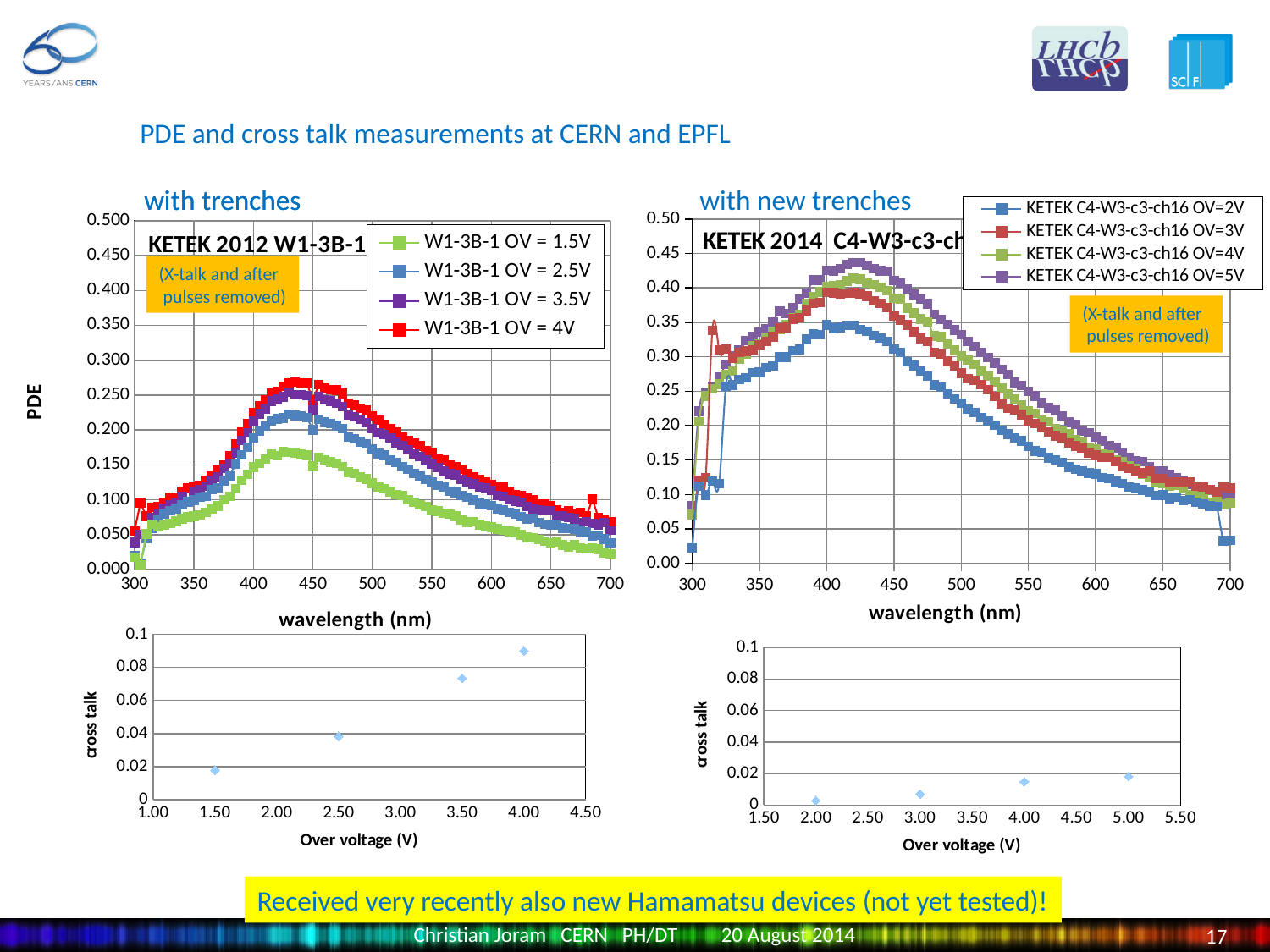
What is the x-axis label of the top-right chart 'KETEK 2014 C4-W3-c3-ch16'? wavelength (nm) In the bottom-right cross talk chart, is the cross talk at an over voltage of 2.00 V greater or less than 0.02? less Which is larger: the cross talk at 4.00 V in the bottom-left chart or the cross talk at 5.00 V in the bottom-right chart? the cross talk at 4.00 V in the bottom-left chart In the top-right chart 'KETEK 2014 C4-W3-c3-ch16', which series has the lowest PDE around 450 nm? KETEK C4-W3-c3-ch16 OV=2V In the bottom-left cross talk chart, is the cross talk at an over voltage of 4.00 V greater or less than 0.08? greater In the bottom-left cross talk chart, does the cross talk rise or fall as the over voltage increases? rise How many series does the legend list in the top-right chart titled 'KETEK 2014 C4-W3-c3-ch16'? 4 In the top-left chart 'KETEK 2012 W1-3B-1', is the peak PDE of the W1-3B-1 OV = 1.5V series greater or less than 0.200? less How many series does the legend list in the top-left chart titled 'KETEK 2012 W1-3B-1'? 4 In the top-left chart 'KETEK 2012 W1-3B-1', which series reaches the highest PDE around 450 nm? W1-3B-1 OV = 4V How many data points are plotted in the bottom-left cross talk chart? 4